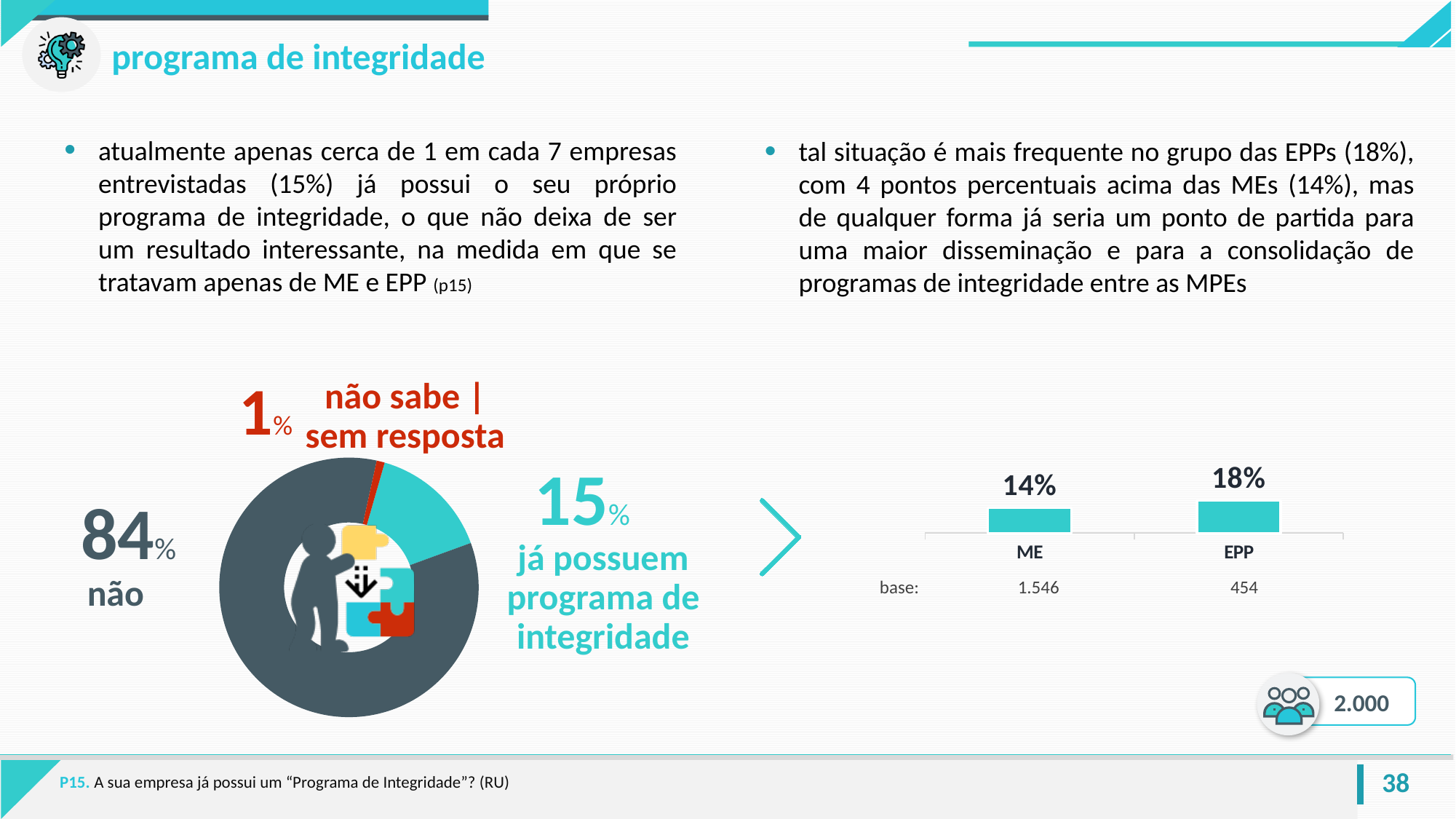
In the bar chart on the right, what is the value for ME? 14% In the pie chart on the left, which category has the largest slice? não What kind of chart is shown on the right side of the slide? bar chart In the bar chart on the right, what is the value for EPP? 18% In the pie chart on the left, how many slices are shown? 3 In the pie chart on the left, what share is "não sabe | sem resposta"? 1% In the bar chart on the right, what is the difference between the EPP and ME values? 4 percentage points In the pie chart on the left, which category has the smallest slice? não sabe | sem resposta In the pie chart on the left, what share of companies already have a programa de integridade? 15% In the bar chart on the right, what is the base (number of respondents) for ME? 1.546 In the pie chart on the left, what share of companies answered "não"? 84% In the bar chart on the right, which group has the higher value, ME or EPP? EPP